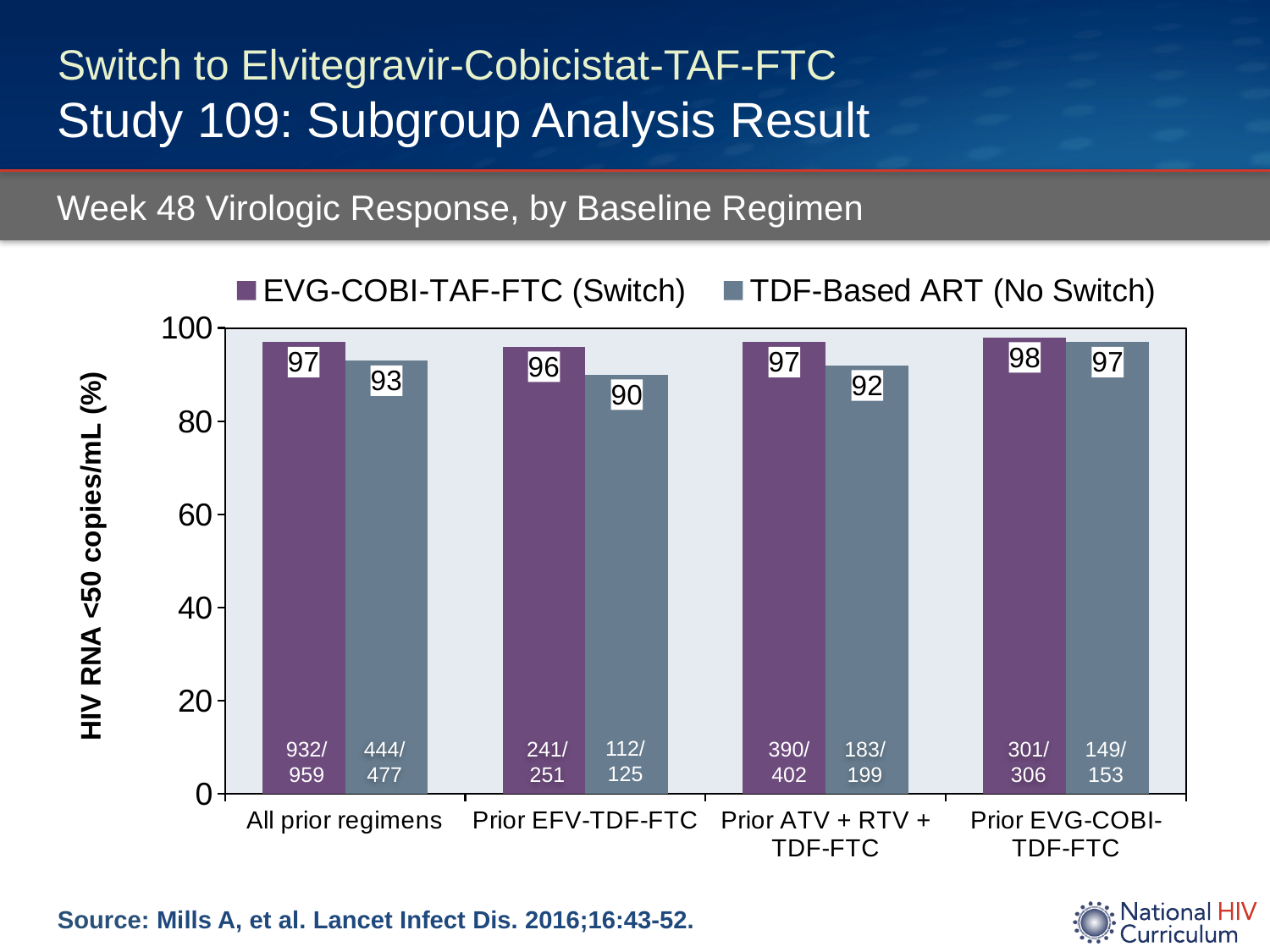
How many series does the legend list? 2 What is the value for TDF-Based ART (No Switch) in the Prior ATV + RTV + TDF-FTC group? 92 What is the value for EVG-COBI-TAF-FTC (Switch) in the All prior regimens group? 97 What is the label of the y axis? HIV RNA <50 copies/mL (%) How many baseline regimen groups are shown on the x axis? 4 What is the difference between the EVG-COBI-TAF-FTC (Switch) and TDF-Based ART (No Switch) values in the Prior EFV-TDF-FTC group? 6 Which baseline regimen group has the highest value for EVG-COBI-TAF-FTC (Switch)? Prior EVG-COBI-TDF-FTC What kind of chart is shown on the slide? Bar chart What is the value for TDF-Based ART (No Switch) in the Prior EFV-TDF-FTC group? 90 Which baseline regimen group has the lowest value for TDF-Based ART (No Switch)? Prior EFV-TDF-FTC In the Prior ATV + RTV + TDF-FTC group, which series has the larger value? EVG-COBI-TAF-FTC (Switch) What is the value for EVG-COBI-TAF-FTC (Switch) in the Prior EVG-COBI-TDF-FTC group? 98